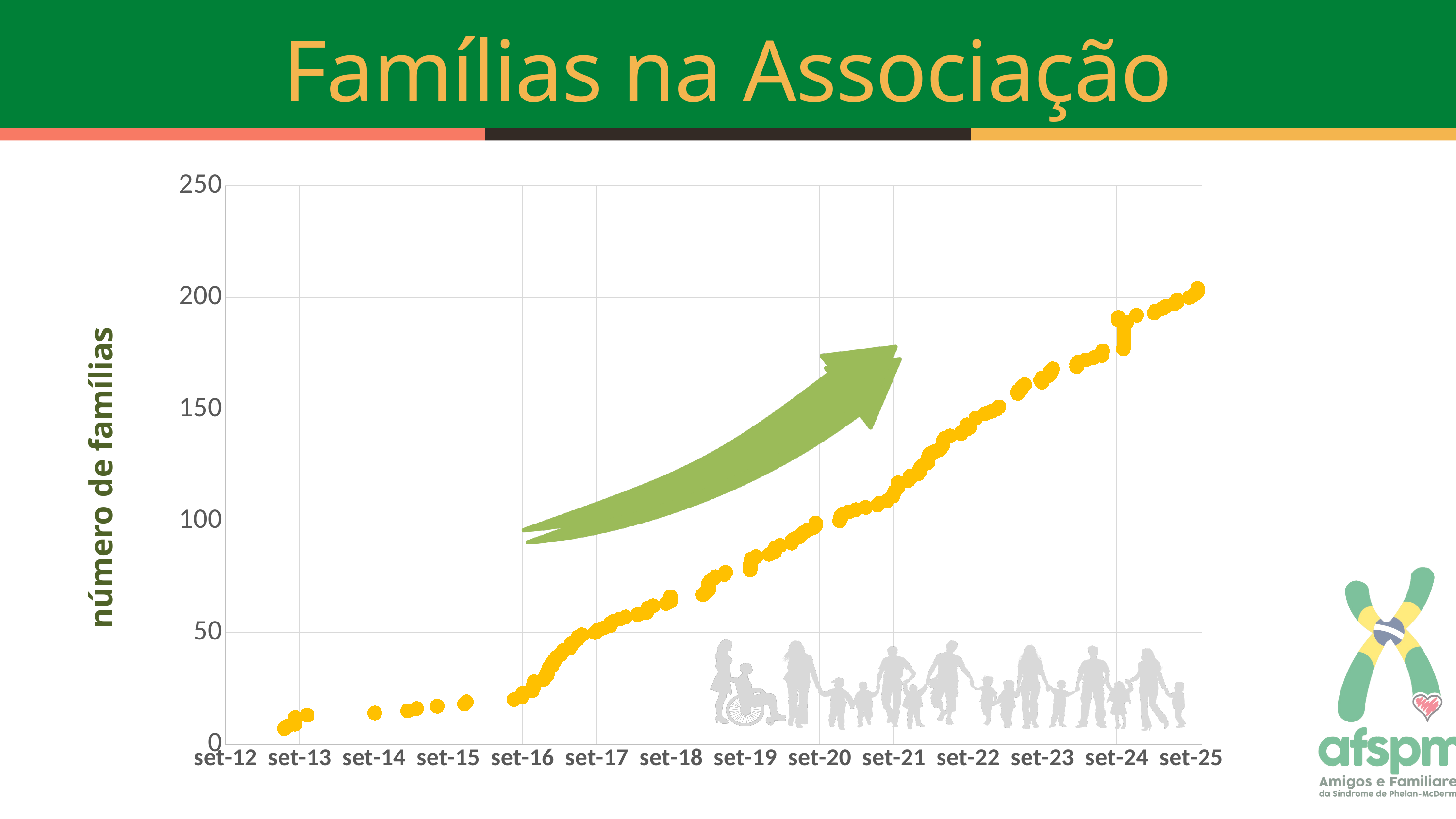
What is the title of the y axis? número de famílias Is the value for set-23 greater or less than 150? greater Do the values rise or fall from set-12 to set-25? rise What kind of chart is shown on the slide? scatter chart Is the value for set-19 greater or less than 100? less Which is larger, the value for set-24 or the value for set-18? set-24 Is the value for set-13 greater or less than 50? less What is the highest value shown on the y axis? 250 How many labelled ticks are on the x axis? 14